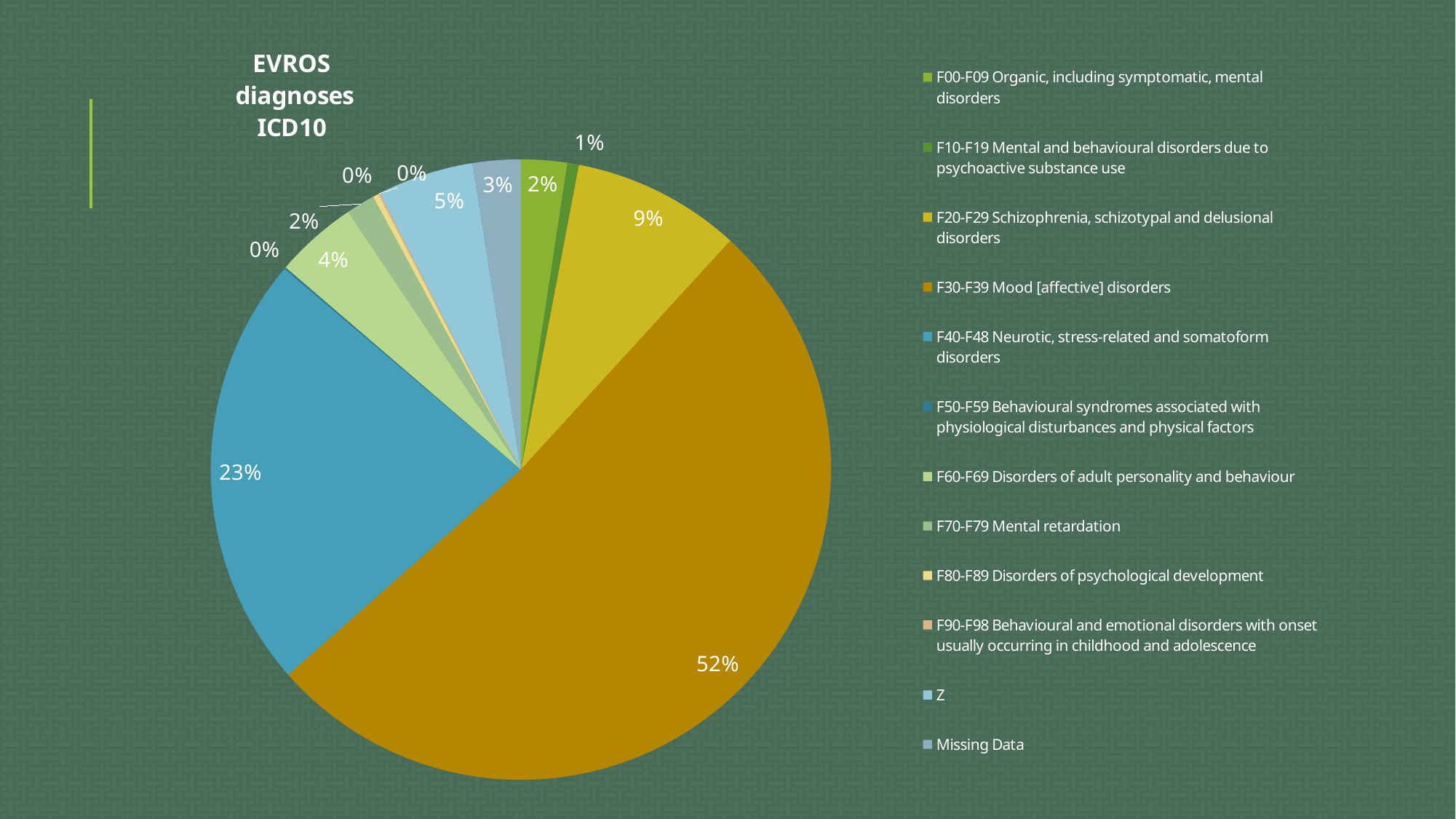
What percentage is shown for F60-F69 Disorders of adult personality and behaviour? 4% Which category has the largest share of the pie? F30-F39 Mood [affective] disorders What is the title of the chart? EVROS diagnoses ICD10 Which is larger, the share for F20-F29 Schizophrenia, schizotypal and delusional disorders or the share for Z? F20-F29 Schizophrenia, schizotypal and delusional disorders What share of the pie is F40-F48 Neurotic, stress-related and somatoform disorders? 23% How many categories does the legend list? 12 What percentage is shown for Z? 5% What share of the pie is F20-F29 Schizophrenia, schizotypal and delusional disorders? 9% What share of the pie is F30-F39 Mood [affective] disorders? 52% What type of chart is shown on the slide? pie chart What percentage is shown for Missing Data? 3% What is the difference in percentage points between F30-F39 Mood [affective] disorders and F40-F48 Neurotic, stress-related and somatoform disorders? 29